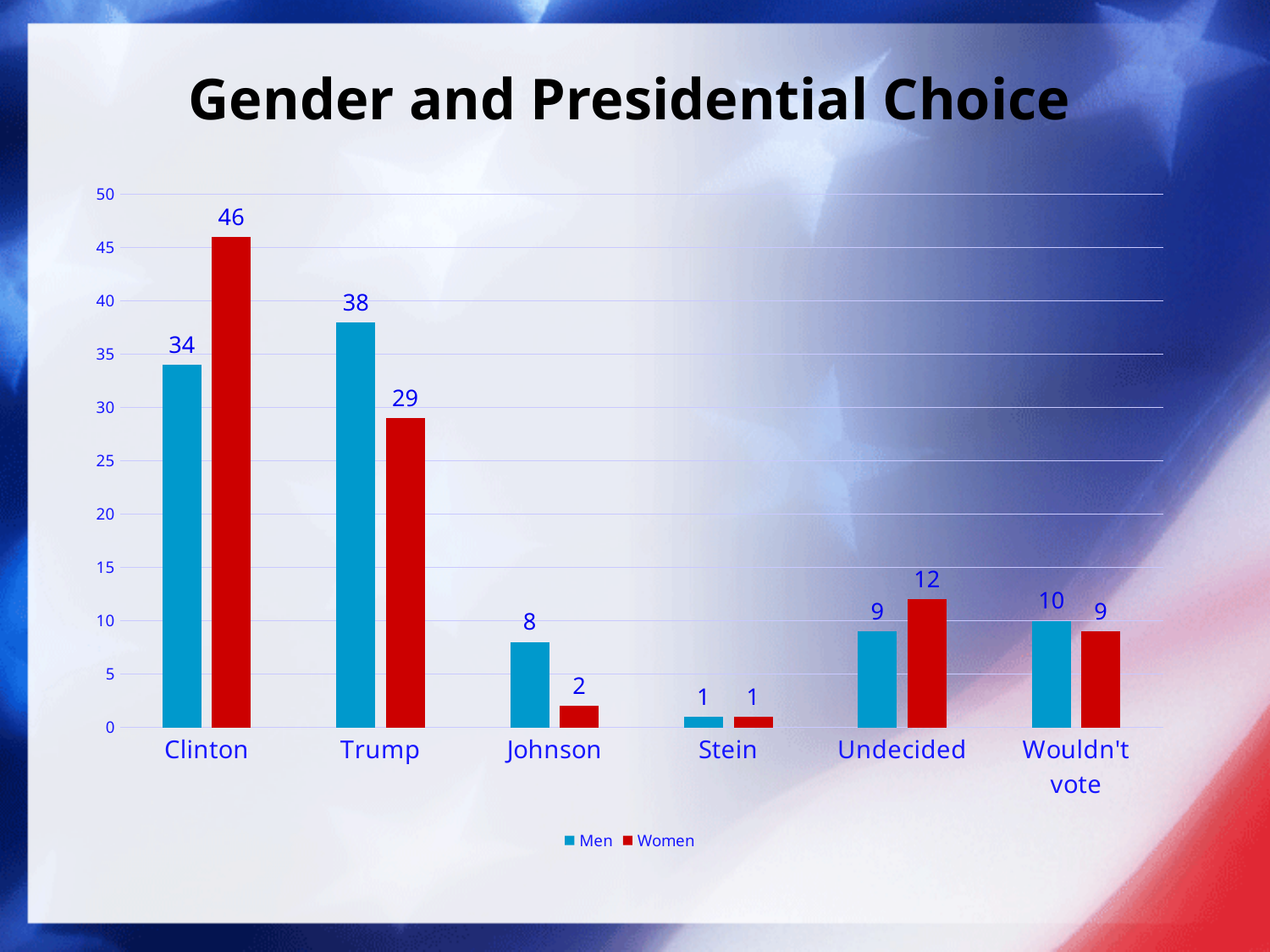
Which category has the highest value for Men? Trump Is the value for Women for Undecided greater or less than 10? greater What is the value for Women for Johnson? 2 Which is larger for Trump, the Men value or the Women value? Men What kind of chart is shown on the slide? Bar chart What is the value for Women for Clinton? 46 What is the value for Men for Trump? 38 What is the difference between the Women and Men values for Clinton? 12 Which category has the lowest value for Women? Stein How many series does the legend list? 2 How many categories are shown on the x axis? 6 What is the title of the chart? Gender and Presidential Choice